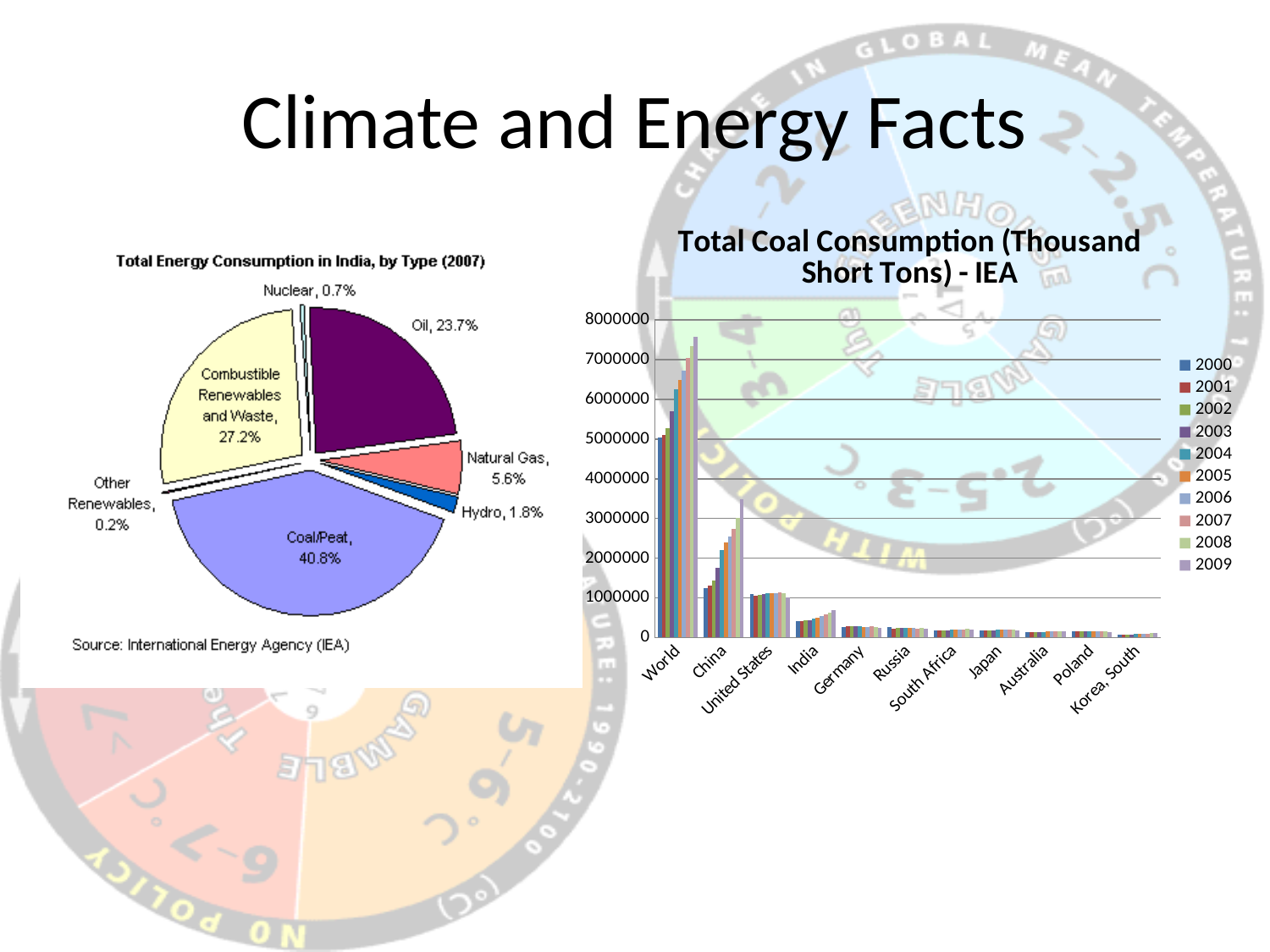
In the chart 'Total Coal Consumption (Thousand Short Tons) - IEA', which country (excluding World) has the highest coal consumption? China In the pie chart 'Total Energy Consumption in India, by Type (2007)', what is the difference between the Coal/Peat share and the Oil share? 17.1% In the pie chart 'Total Energy Consumption in India, by Type (2007)', which type has the smallest share? Other Renewables How many series does the legend of the chart 'Total Coal Consumption (Thousand Short Tons) - IEA' list? 10 How many slices does the pie chart 'Total Energy Consumption in India, by Type (2007)' have? 7 What kind of chart is 'Total Coal Consumption (Thousand Short Tons) - IEA'? Bar chart In the pie chart 'Total Energy Consumption in India, by Type (2007)', which type has the largest share? Coal/Peat In the pie chart 'Total Energy Consumption in India, by Type (2007)', what share does Coal/Peat have? 40.8% In the pie chart 'Total Energy Consumption in India, by Type (2007)', what share does Natural Gas have? 5.6% In the pie chart 'Total Energy Consumption in India, by Type (2007)', which is larger: Hydro or Nuclear? Hydro In the chart 'Total Coal Consumption (Thousand Short Tons) - IEA', is the value for World in 2009 greater or less than 7000000? greater In the pie chart 'Total Energy Consumption in India, by Type (2007)', what share does Oil have? 23.7%